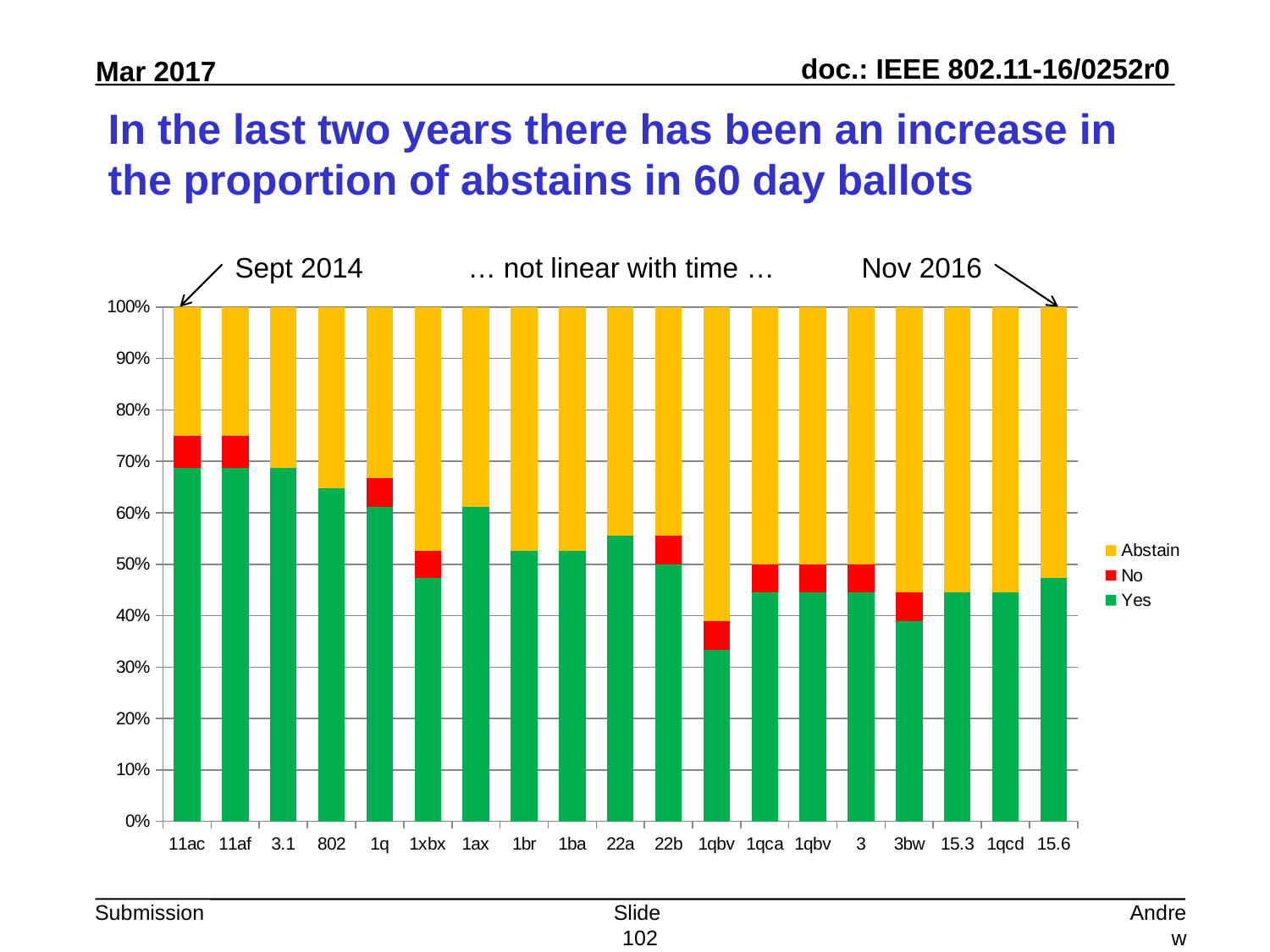
What does each stacked bar total? 100% How many series does the legend list? 3 What colour represents the Abstain series? yellow Which category has the lowest Yes proportion? 1qbv Does the Yes proportion generally rise or fall from left to right across the ballots? fall Is the Yes proportion for 11ac greater or less than 60%? greater Which series are listed in the legend? Abstain, No, Yes How many ballot categories are shown along the x axis? 19 Is the Yes proportion for 3bw greater or less than 50%? less Is the Yes proportion for 802 greater or less than 60%? greater What kind of chart is shown on the slide? stacked bar chart